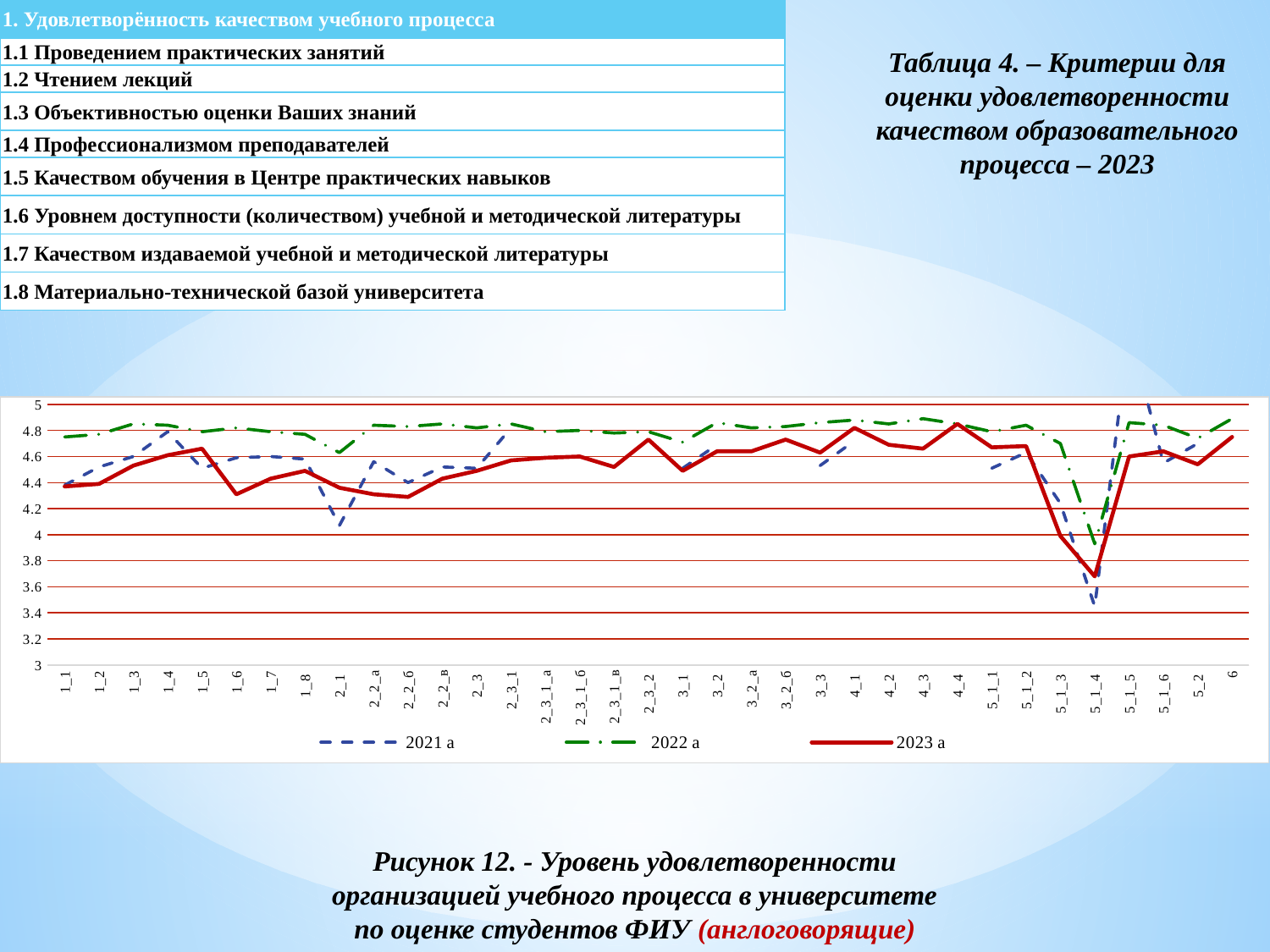
Is the value of the 2023 a series at 1_6 greater or less than 4.6? less What kind of chart is shown on the slide? line chart What are the names of the series listed in the chart legend? 2021 a, 2022 a, 2023 a At which category does the 2021 a series reach its lowest value? 5_1_4 Is the value of the 2021 a series at 5_1_4 greater or less than 4? less Is the value of the 2021 a series at 2_1 greater or less than 4.2? less At category 1_6, which series has the larger value: 2022 a or 2023 a? 2022 a Between categories 5_1_2 and 5_1_4, does the 2023 a series rise or fall? fall How many series does the chart legend list? 3 At which category does the 2023 a series reach its lowest value? 5_1_4 How many categories are shown along the x axis of the chart? 35